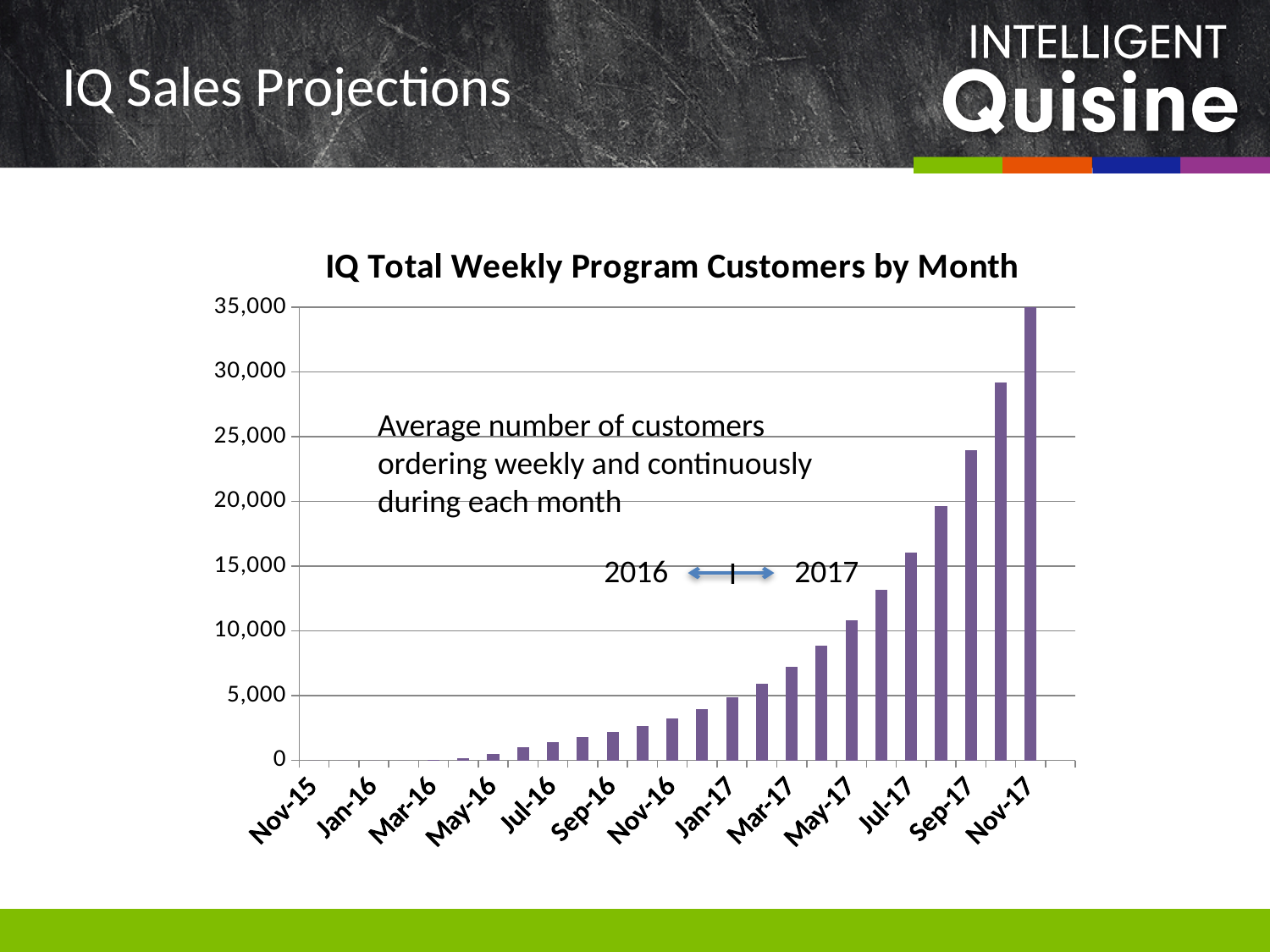
What is the title of the chart? IQ Total Weekly Program Customers by Month Do the values rise or fall from Nov-15 to Nov-17? Rise Which month has the highest number of weekly program customers? Nov-17 Which is larger, the value for Sep-17 or the value for Jul-17? Sep-17 What kind of chart is shown on the slide? Bar chart Is the value for May-17 greater or less than 10,000? greater Is the value for Mar-17 greater or less than 5,000? greater How many month labels are shown on the x axis? 13 Is the value for Nov-16 greater or less than 5,000? less